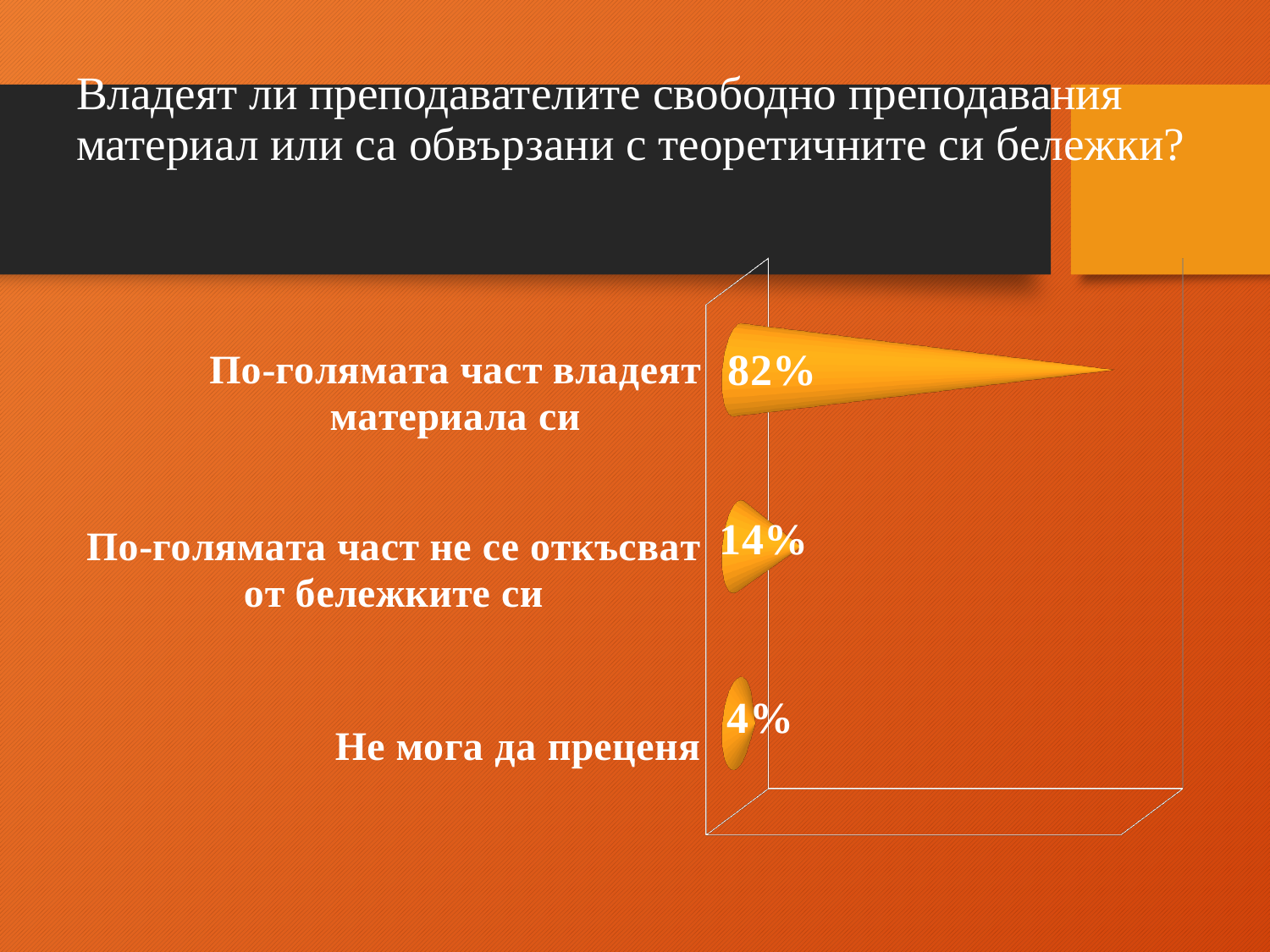
Which is larger: the value for "По-голямата част не се откъсват от бележките си" or for "Не мога да преценя"? По-голямата част не се откъсват от бележките си Which category has the highest value? По-голямата част владеят материала си What is the value for "По-голямата част не се откъсват от бележките си"? 14% What is the difference between the values for "По-голямата част владеят материала си" and "По-голямата част не се откъсват от бележките си"? 68% What is the value for "По-голямата част владеят материала си"? 82% Which category has the lowest value? Не мога да преценя What is the value for "Не мога да преценя"? 4% How many categories are shown in the chart? 3 What kind of chart is shown on the slide? Bar chart What is the difference between the values for "По-голямата част не се откъсват от бележките си" and "Не мога да преценя"? 10% What is the title of the slide containing the chart? Владеят ли преподавателите свободно преподавания материал или са обвързани с теоретичните си бележки? What is the total of the three values shown in the chart? 100%